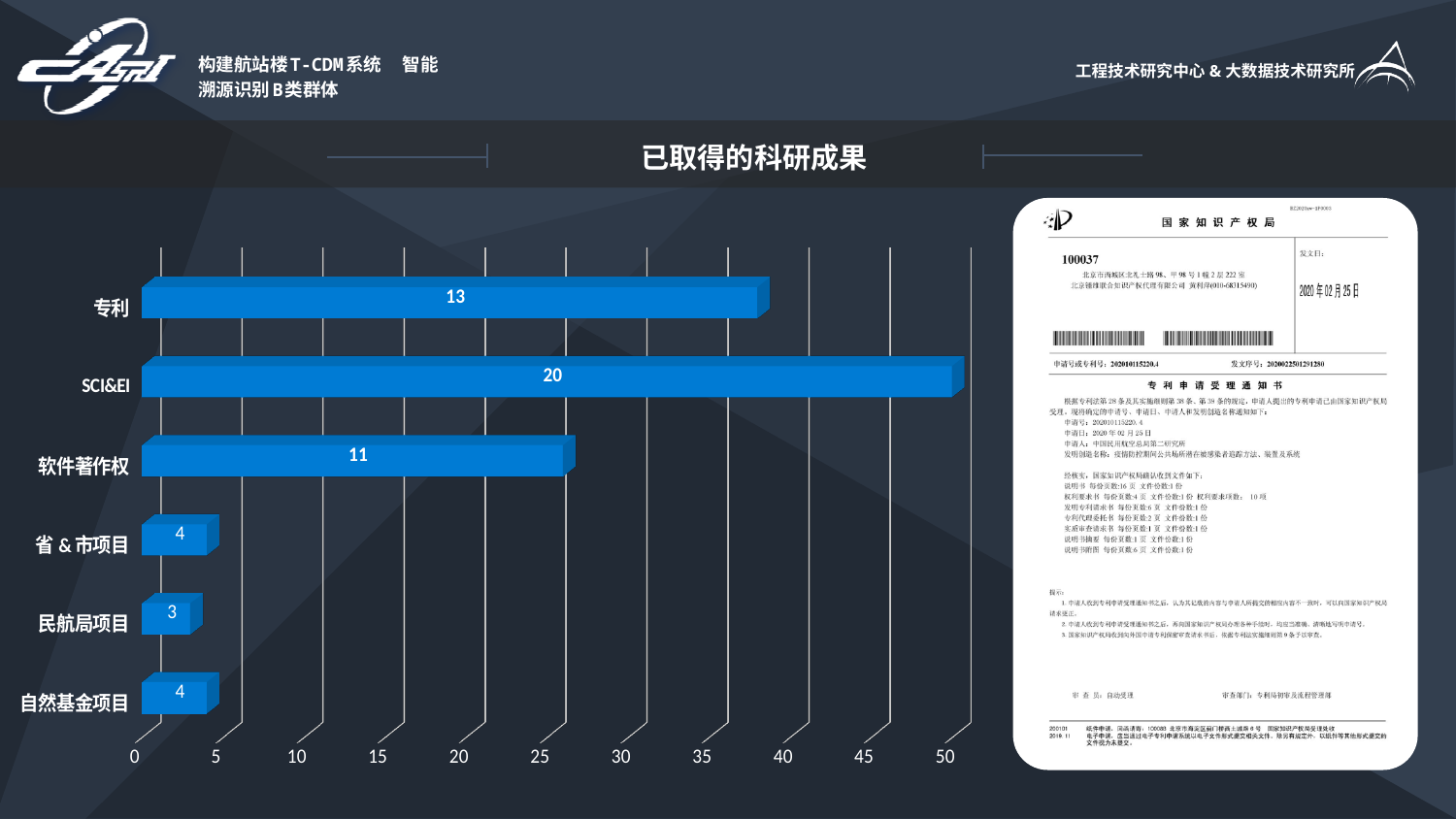
What is the value for 自然基金项目? 4 What is the value for 专利? 13 What is the title shown above the chart? 已取得的科研成果 How many categories are shown in the chart? 6 What is the value for SCI&EI? 20 Which category has the lowest value? 民航局项目 What is the value for 软件著作权? 11 Which is larger, the value for 专利 or the value for 软件著作权? 专利 What type of chart is shown on the slide? bar chart What is the difference between the values for SCI&EI and 专利? 7 Which category has the highest value? SCI&EI What is the value for 民航局项目? 3